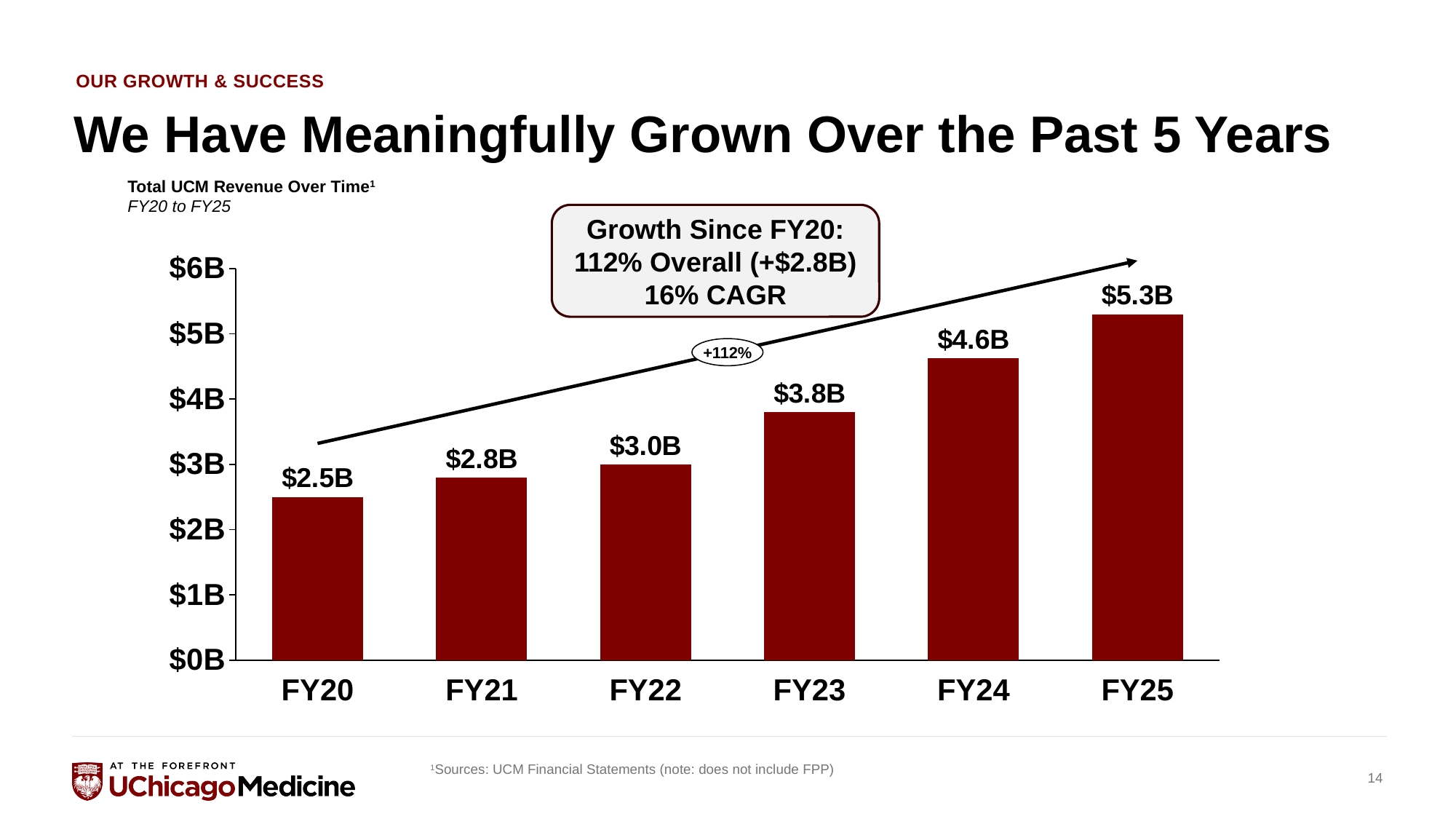
Which fiscal year has the lowest total UCM revenue? FY20 Does total UCM revenue rise or fall from FY20 to FY25? Rise What is the total UCM revenue for FY20? $2.5B Is the revenue for FY24 greater or less than $4B? greater What is the difference in revenue between FY25 and FY20? $2.8B Which fiscal year has the highest total UCM revenue? FY25 What is the total UCM revenue for FY23? $3.8B What is the total UCM revenue for FY25? $5.3B How many fiscal years are shown on the chart? 6 Which year has higher revenue, FY22 or FY24? FY24 What is the difference in revenue between FY24 and FY23? $0.8B What kind of chart is used to show total UCM revenue over time? Bar chart